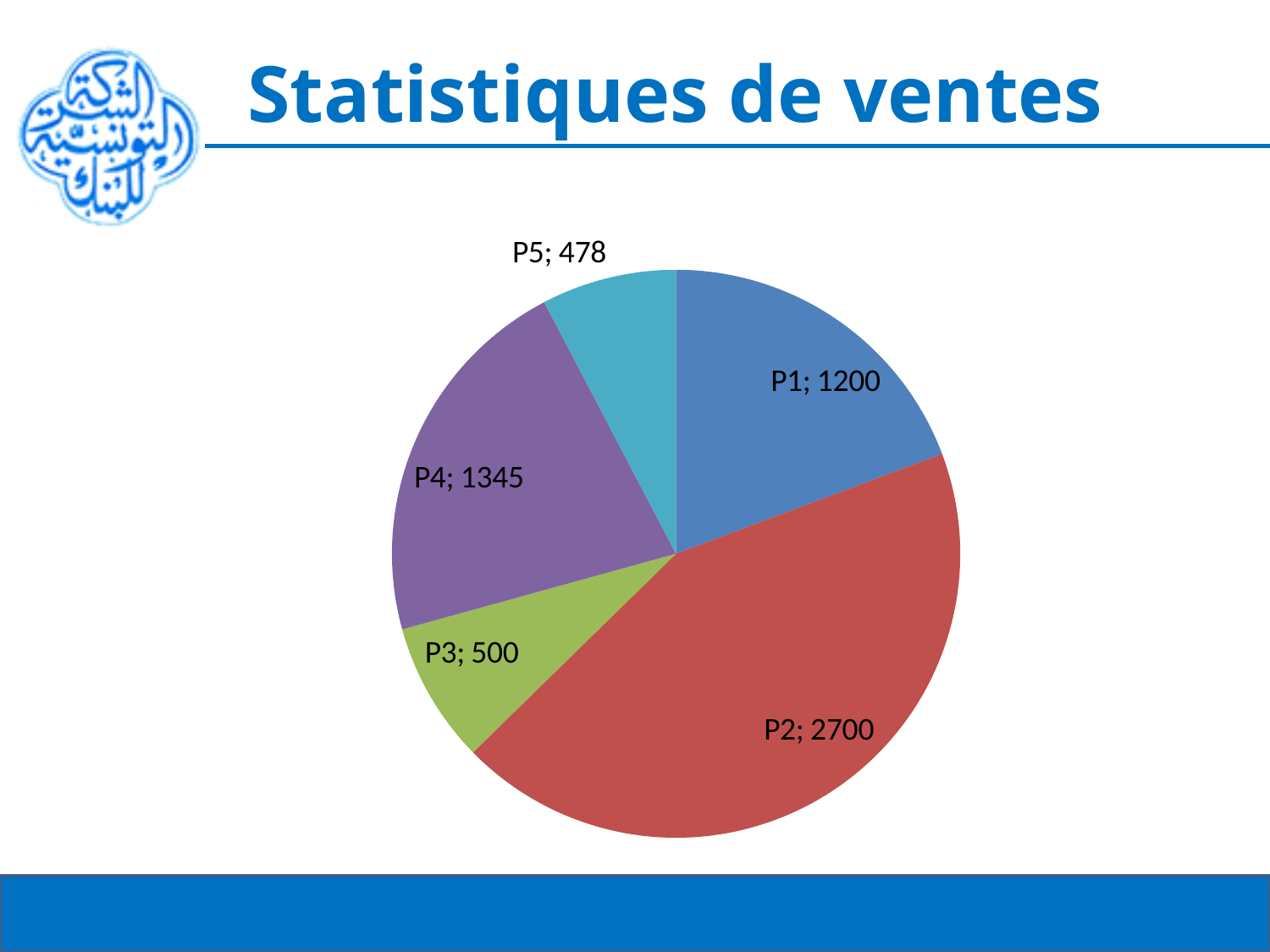
Which category has the largest slice of the pie chart? P2 What kind of chart is shown on the slide? Pie chart What is the total of all the values in the pie chart? 6223 What is the value for P2 in the pie chart? 2700 What is the value for P4 in the pie chart? 1345 Which category has the smallest slice of the pie chart? P5 What is the value for P5 in the pie chart? 478 How many categories are shown in the pie chart? 5 What is the title of the slide containing the pie chart? Statistiques de ventes Which is larger, the value for P1 or the value for P4? P4 What is the difference between the values for P2 and P1? 1500 What is the difference between the values for P4 and P3? 845